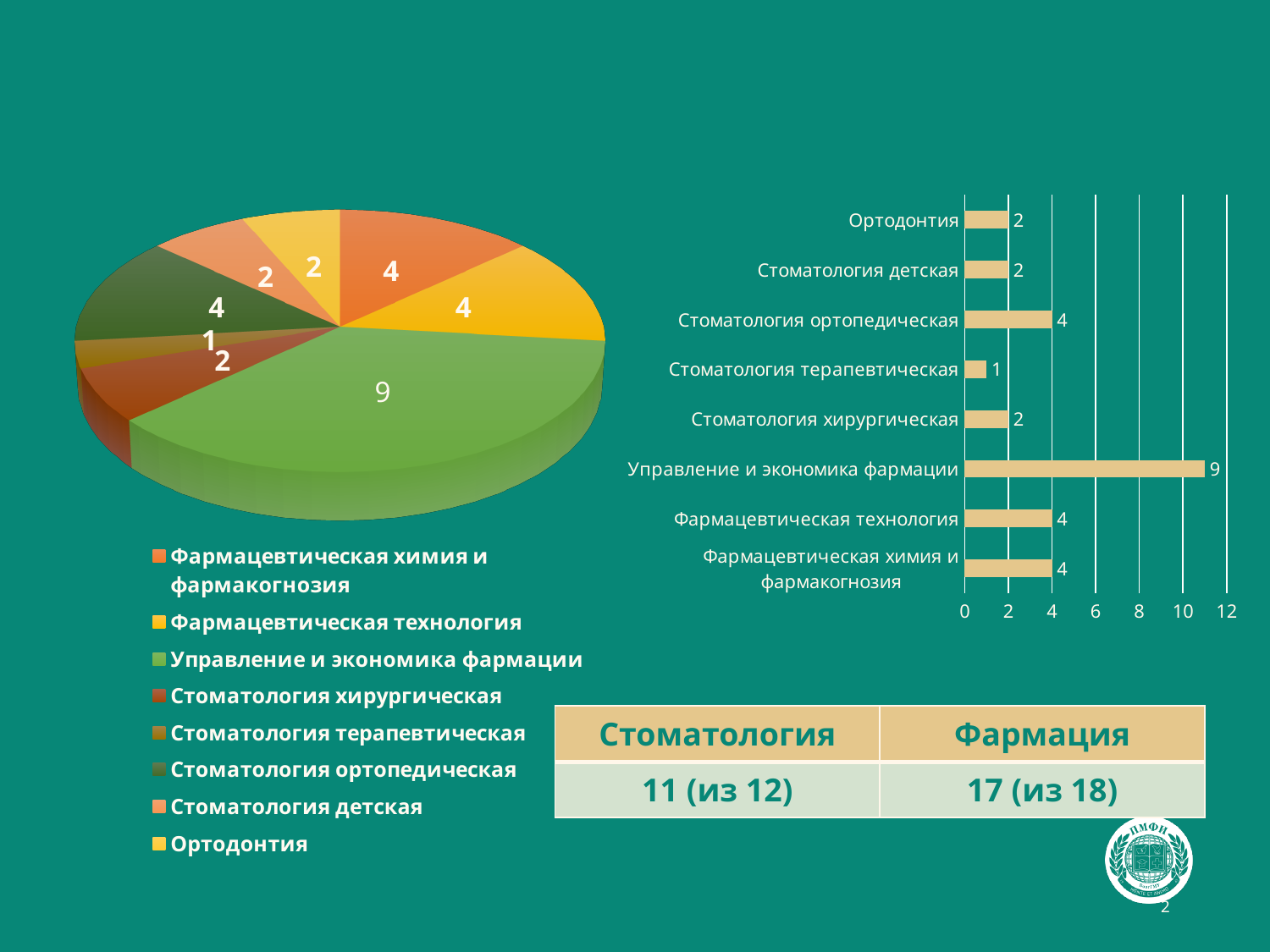
In the bar chart on the right, which category has the lowest value? Стоматология терапевтическая In the bar chart on the right, which is larger: the value for Фармацевтическая технология or the value for Стоматология детская? Фармацевтическая технология In the bar chart on the right, what is the value for Стоматология терапевтическая? 1 What kind of chart is the chart on the left of the slide? pie chart In the bar chart on the right, what is the value for Управление и экономика фармации? 9 What kind of chart is the chart on the right of the slide? bar chart In the bar chart on the right, what is the value for Ортодонтия? 2 How many categories are shown in the bar chart on the right? 8 In the bar chart on the right, is the value for Управление и экономика фармации greater or less than 8? greater In the bar chart on the right, which category has the highest value? Управление и экономика фармации In the bar chart on the right, what is the difference between the values for Управление и экономика фармации and Стоматология ортопедическая? 5 In the pie chart on the left, what is the value of the largest slice? 9